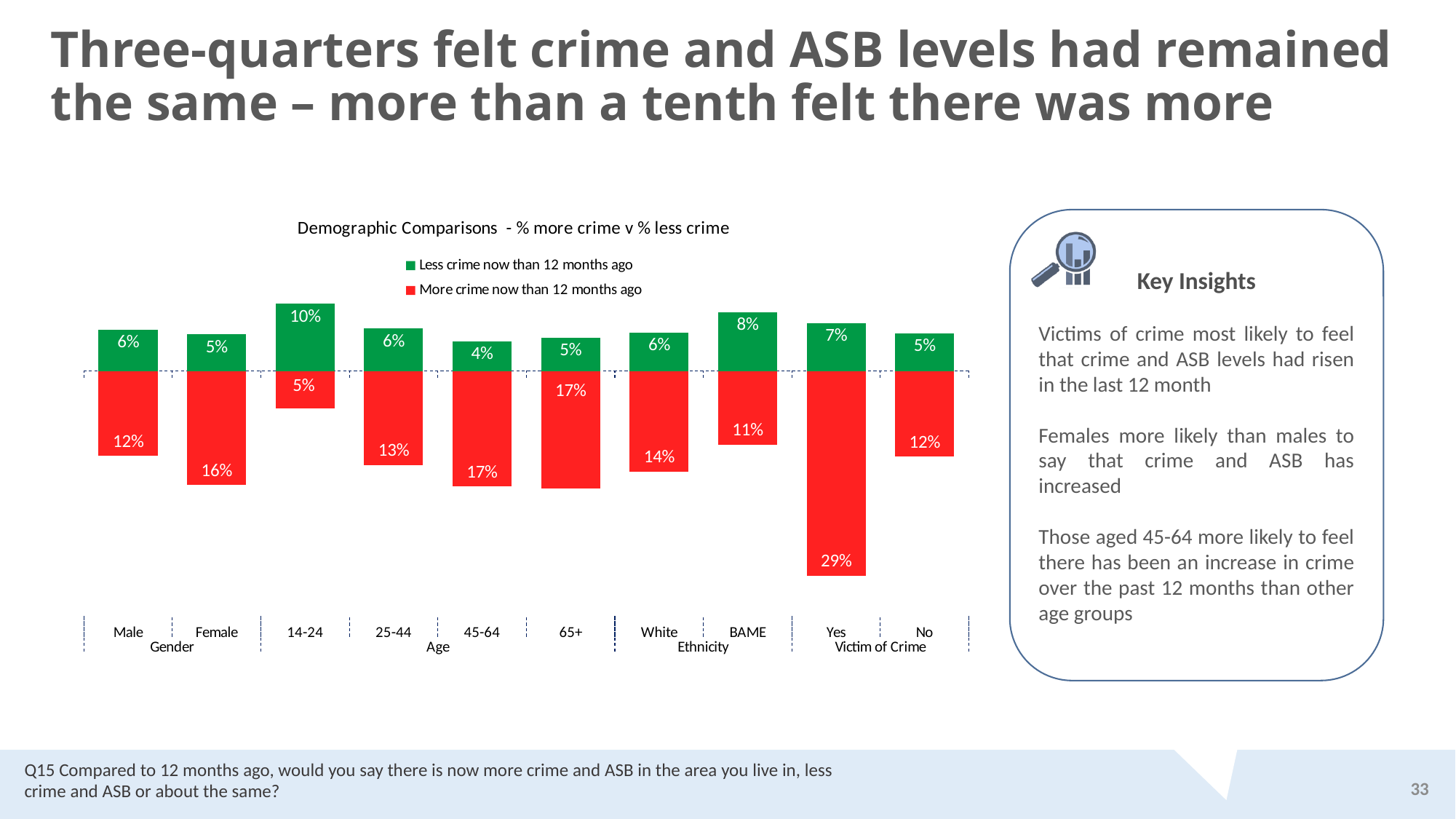
What colour represents 'More crime now than 12 months ago' in the chart? Red Which category has the lowest value for 'More crime now than 12 months ago'? 14-24 Which category has the lowest value for 'Less crime now than 12 months ago'? 45-64 Which group has a higher value for 'More crime now than 12 months ago': White or BAME? White What percentage of the 14-24 age group said there is less crime now than 12 months ago? 10% What percentage of females said there is more crime now than 12 months ago? 16% What type of chart is shown on the slide? Bar chart What is the difference in percentage points between females and males saying there is more crime now than 12 months ago? 4 percentage points How many series does the chart legend list? 2 Which category has the highest value for 'More crime now than 12 months ago'? Yes (Victim of Crime) How many demographic categories are shown on the x axis of the chart? 10 What percentage of victims of crime (Yes) said there is more crime now than 12 months ago? 29%